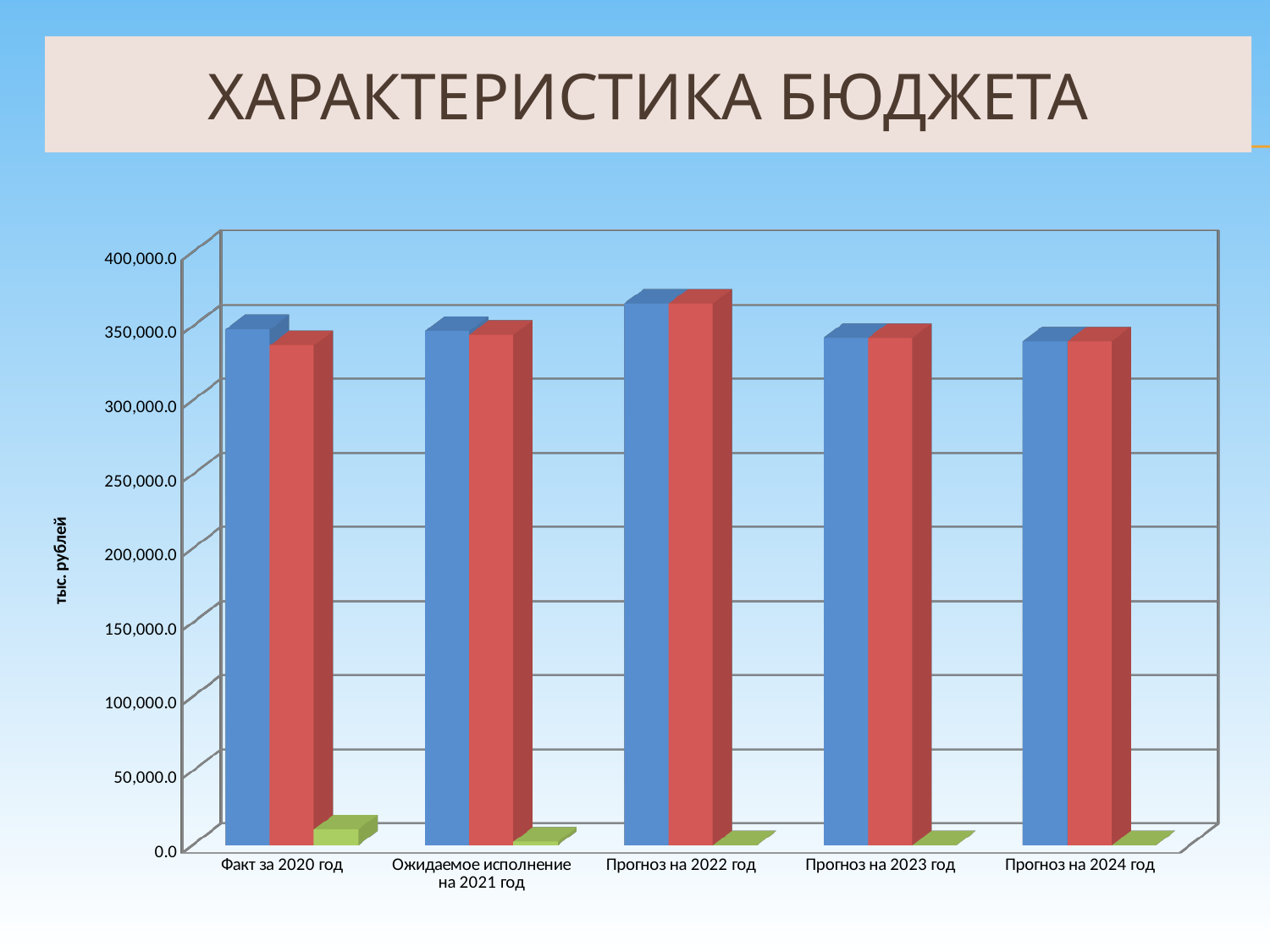
What is the label on the vertical axis of the chart? тыс. рублей How many bars are plotted for each category in the chart? 3 What kind of chart is shown on the slide? bar chart Which category has the tallest blue bar? Прогноз на 2022 год What is the title of the slide containing the chart? ХАРАКТЕРИСТИКА БЮДЖЕТА How many categories are shown along the x axis of the chart? 5 Which category has the tallest green bar? Факт за 2020 год Which is larger: the red bar for Прогноз на 2022 год or the green bar for Прогноз на 2022 год? the red bar Is the green bar for Прогноз на 2023 год greater or less than 50,000.0? less Is the blue bar for Факт за 2020 год greater or less than 300,000.0? greater Is the blue bar for Прогноз на 2022 год greater or less than 350,000.0? greater Which is larger: the blue bar for Прогноз на 2022 год or the blue bar for Прогноз на 2024 год? Прогноз на 2022 год